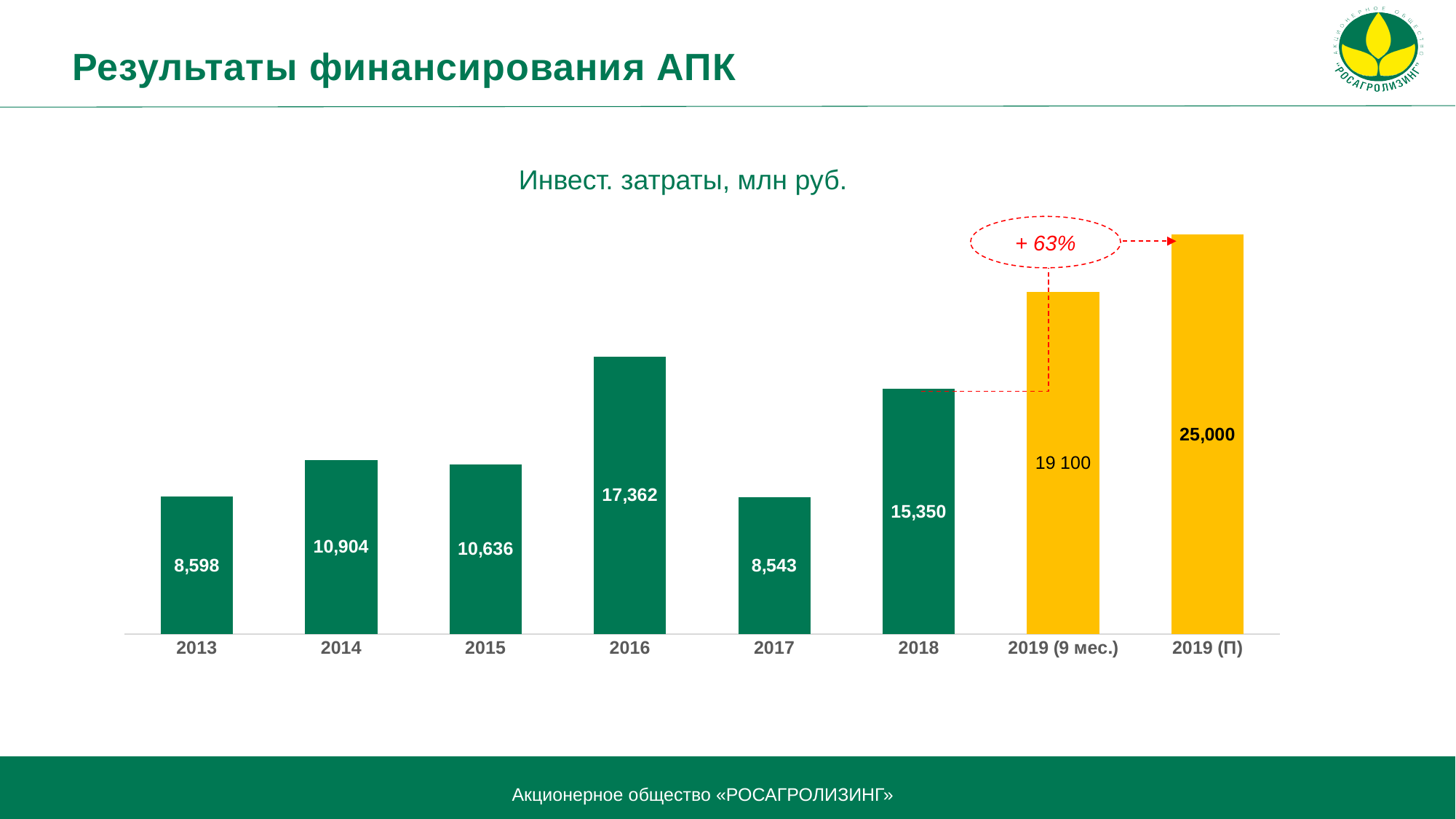
Which category has the highest value? 2019 (П) What is the value for 2019 (9 мес.)? 19 100 Which is larger, the value for 2016 or the value for 2018? 2016 What is the difference between the values for 2016 and 2015? 6,726 Which category has the lowest value? 2017 What is the difference between the values for 2019 (П) and 2019 (9 мес.)? 5,900 How many categories are shown on the x axis? 8 What is the value for 2017? 8,543 Do the values rise or fall from 2017 to 2019 (П)? Rise What kind of chart is shown on the slide? Bar chart What is the value for 2016? 17,362 What percentage change is shown in the red dashed annotation above the 2019 bars? + 63%